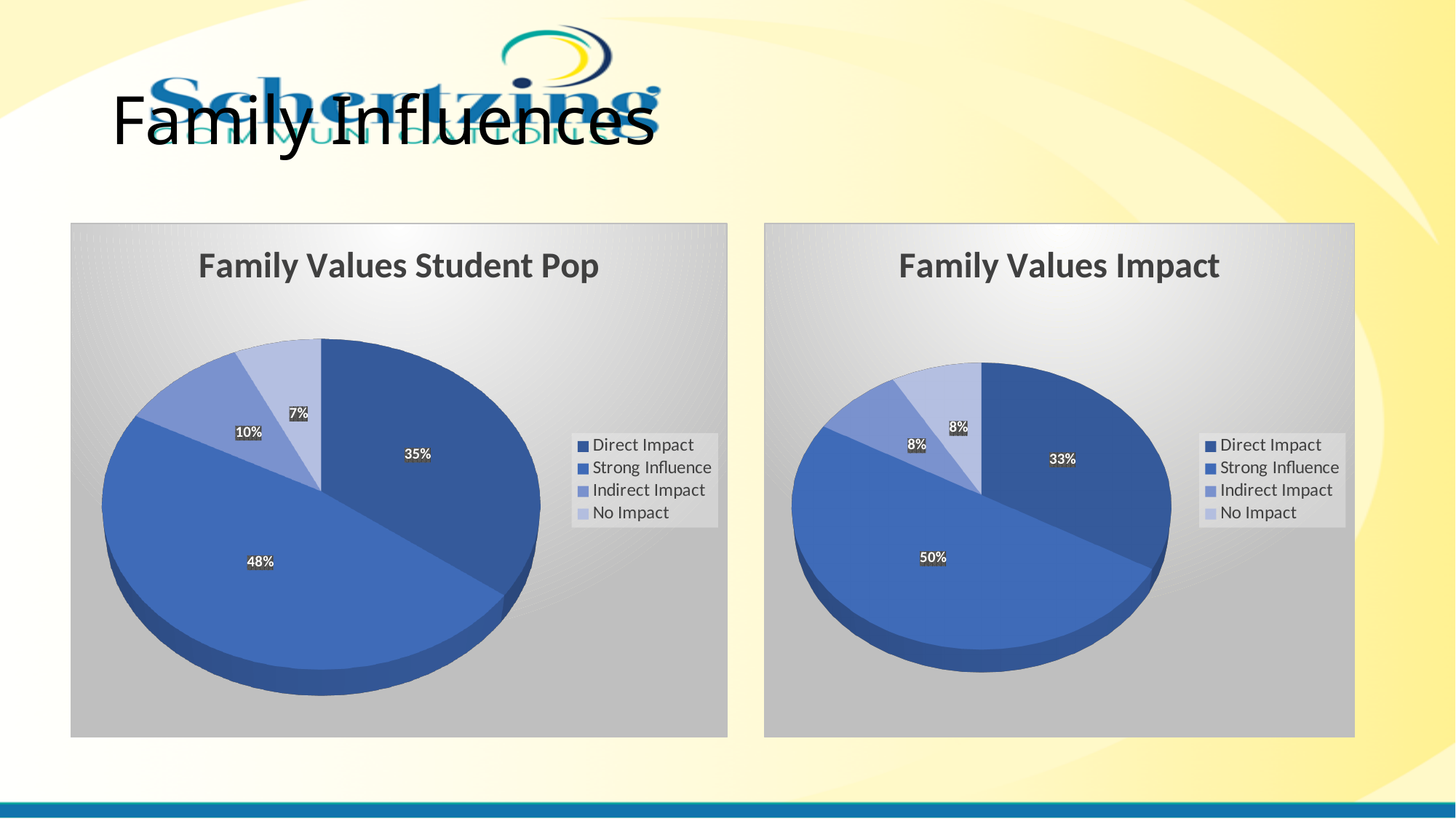
In the 'Family Values Student Pop' chart, what is the difference between the Strong Influence and Direct Impact percentages? 13% In the 'Family Values Student Pop' chart, which category has the largest slice? Strong Influence In the 'Family Values Impact' chart, which category has the largest slice? Strong Influence How many categories does the legend of the 'Family Values Impact' chart list? 4 In the 'Family Values Impact' chart, what percentage is shown for Direct Impact? 33% In the 'Family Values Student Pop' chart, which category has the smallest slice? No Impact In the 'Family Values Student Pop' chart, what percentage is shown for Strong Influence? 48% In the 'Family Values Student Pop' chart, what percentage is shown for Direct Impact? 35% What type of chart is the 'Family Values Student Pop' chart? Pie chart In the 'Family Values Impact' chart, which is larger, Direct Impact or Strong Influence? Strong Influence In the 'Family Values Impact' chart, what percentage is shown for Strong Influence? 50% In the 'Family Values Student Pop' chart, what percentage is shown for No Impact? 7%